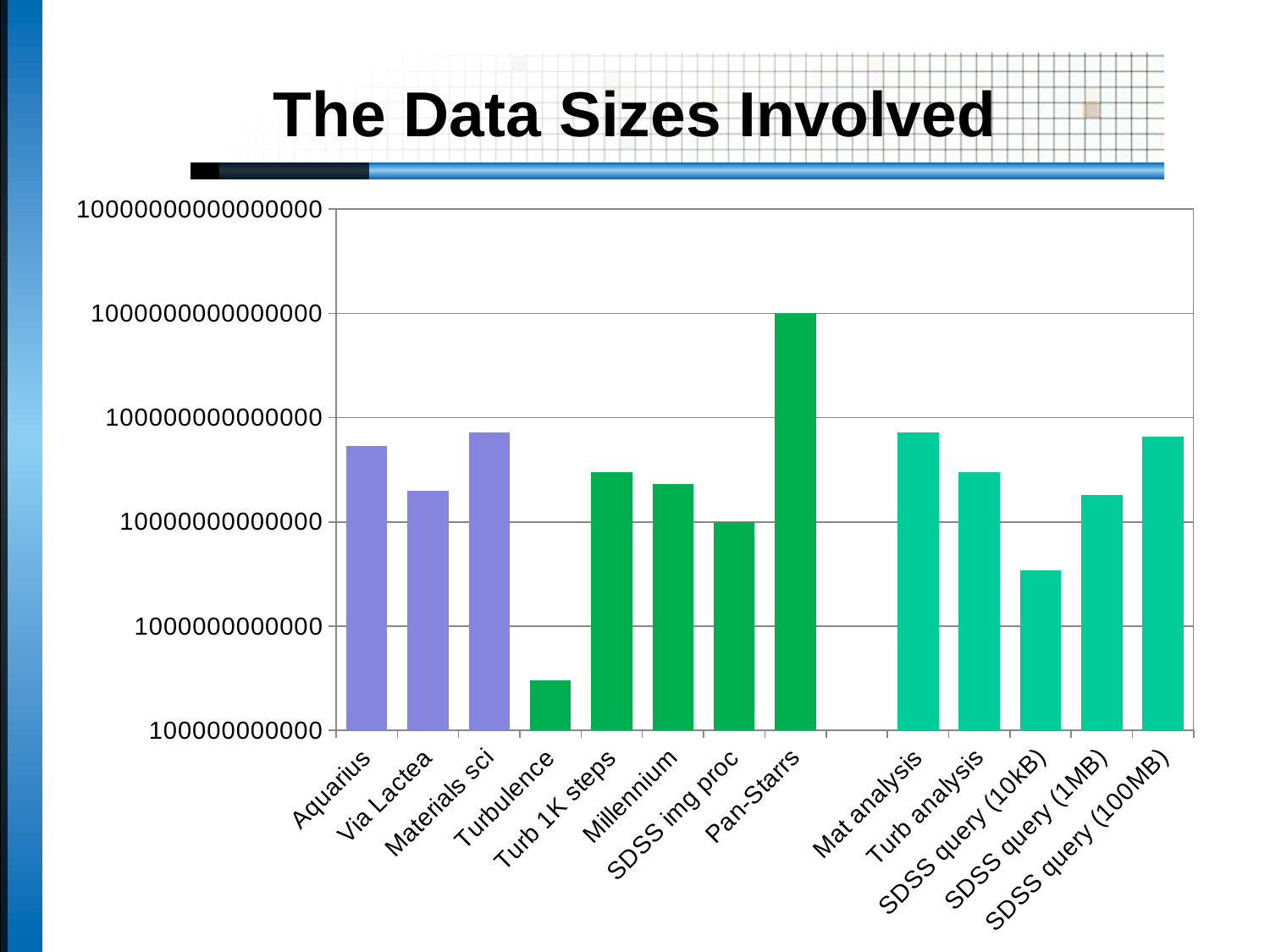
Is the value for Turbulence greater or less than 1000000000000? less How many labelled categories are shown on the x axis? 13 What is the value for Pan-Starrs? 1000000000000000 Which category has the highest value? Pan-Starrs Is the value for Mat analysis greater or less than 1000000000000000? less What kind of chart is shown on the slide? bar chart Which is larger, the value for Via Lactea or the value for Materials sci? Materials sci Which category has the lowest value? Turbulence What is the value for SDSS img proc? 10000000000000 What is the title of the slide? The Data Sizes Involved Which is larger, the value for SDSS query (10kB) or the value for SDSS query (100MB)? SDSS query (100MB) Is the value for Aquarius greater or less than 100000000000000? less